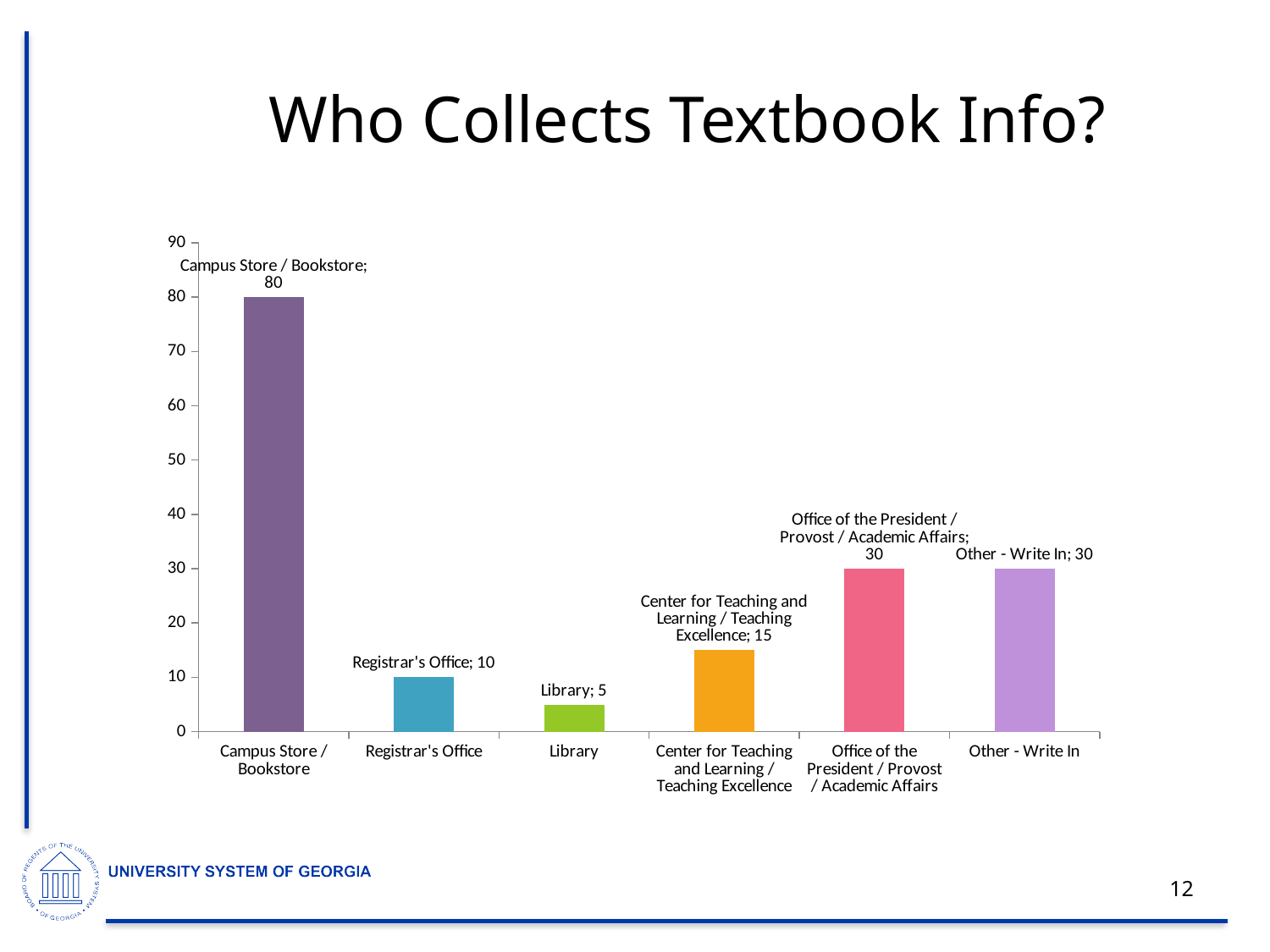
What is the value for Registrar's Office? 10 What is the value for Library? 5 What is the value for Campus Store / Bookstore? 80 Which category has the highest value? Campus Store / Bookstore What is the title of the slide? Who Collects Textbook Info? What is the difference between the values for Campus Store / Bookstore and Other - Write In? 50 What kind of chart is shown on the slide? Bar chart Which category has the lowest value? Library What is the value for Center for Teaching and Learning / Teaching Excellence? 15 Which is larger, the value for Registrar's Office or the value for Center for Teaching and Learning / Teaching Excellence? Center for Teaching and Learning / Teaching Excellence How many categories are shown on the x axis? 6 What is the value for Office of the President / Provost / Academic Affairs? 30